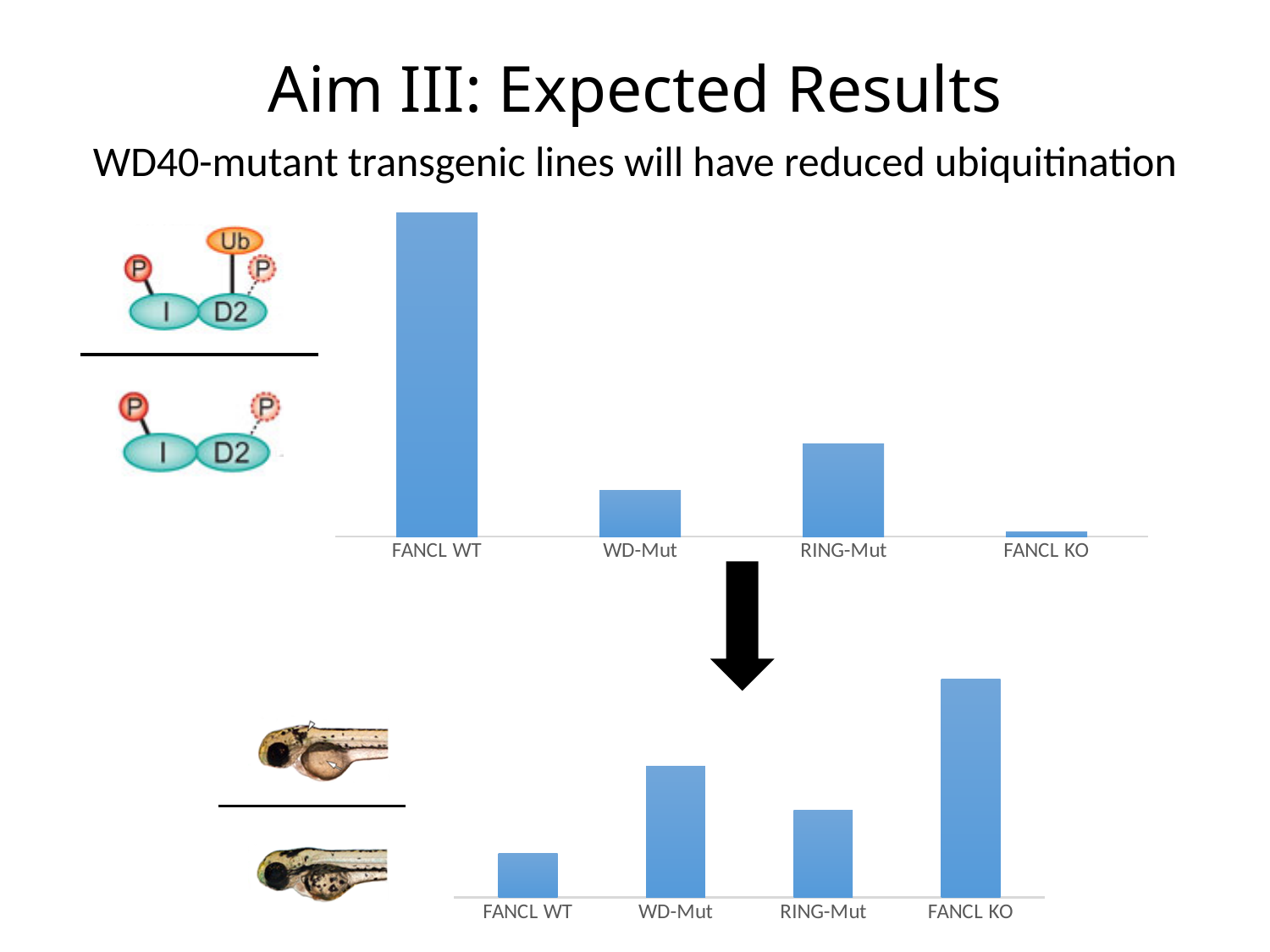
What colour are the bars in the bottom chart? Blue In the bottom chart, which category has the tallest bar? FANCL KO What type of chart is the top chart? Bar chart How many categories are shown in the top chart? 4 What type of chart is the bottom chart? Bar chart In the top chart, which bar is taller, WD-Mut or RING-Mut? RING-Mut In the top chart, which category has the tallest bar? FANCL WT In the top chart, which category has the shortest bar? FANCL KO In the bottom chart, which category has the shortest bar? FANCL WT In the top chart, which bar is taller, FANCL WT or FANCL KO? FANCL WT How many categories are shown in the bottom chart? 4 In the bottom chart, which bar is taller, WD-Mut or RING-Mut? WD-Mut